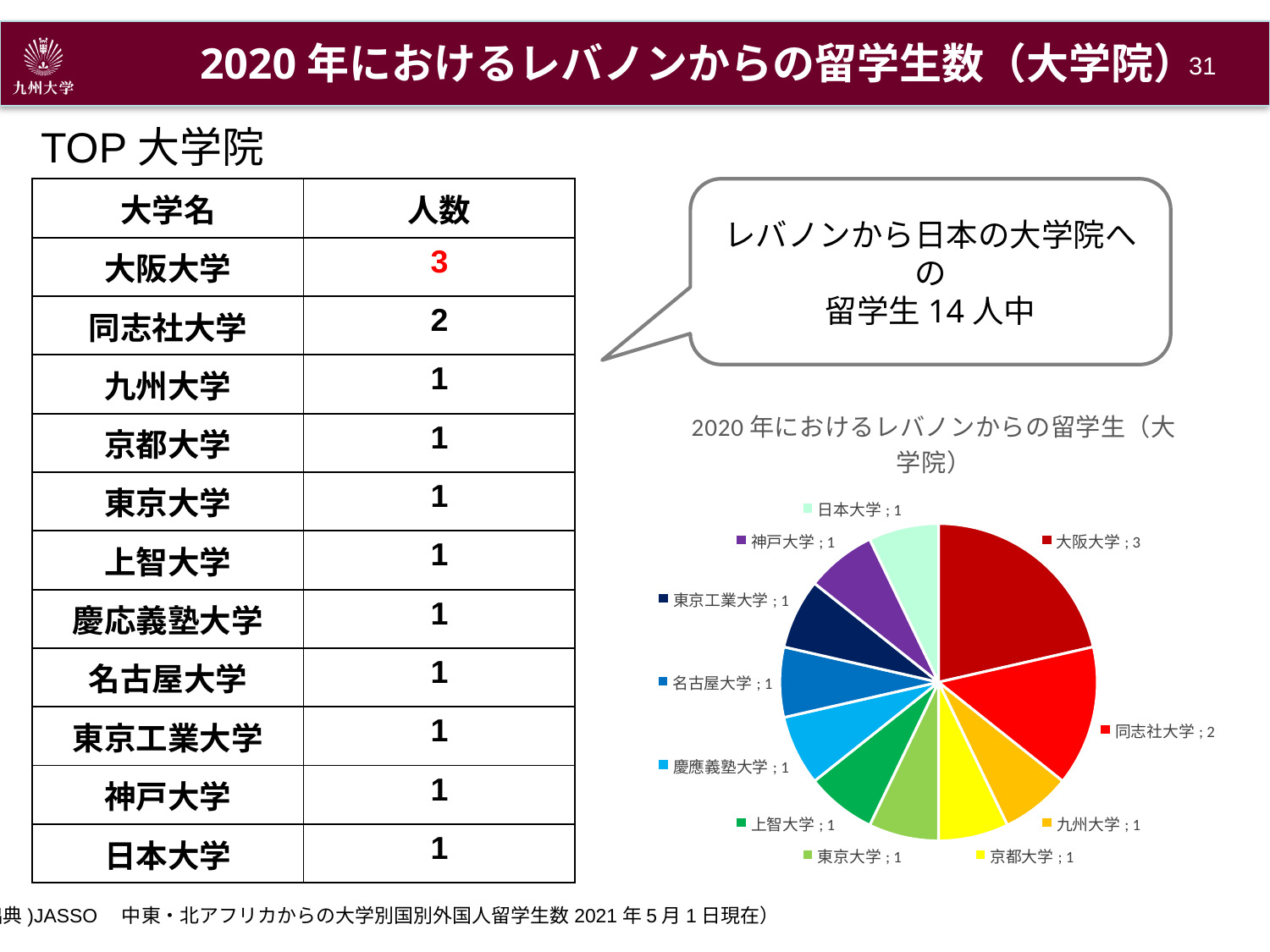
Which university has the largest slice in the pie chart? 大阪大学 What is the value for 神戸大学 in the pie chart? 1 What is the difference between the values for 大阪大学 and 同志社大学? 1 How many slices does the pie chart have? 11 What is the value for 九州大学 in the pie chart? 1 What is the value for 同志社大学 in the pie chart? 2 What kind of chart is shown on the slide? pie chart Which is larger in the pie chart, 同志社大学 or 京都大学? 同志社大学 What is the title of the pie chart? 2020年におけるレバノンからの留学生（大学院） What is the difference between the values for 大阪大学 and 東京工業大学? 2 What is the total of all the values in the pie chart? 14 What is the value for 大阪大学 in the pie chart? 3